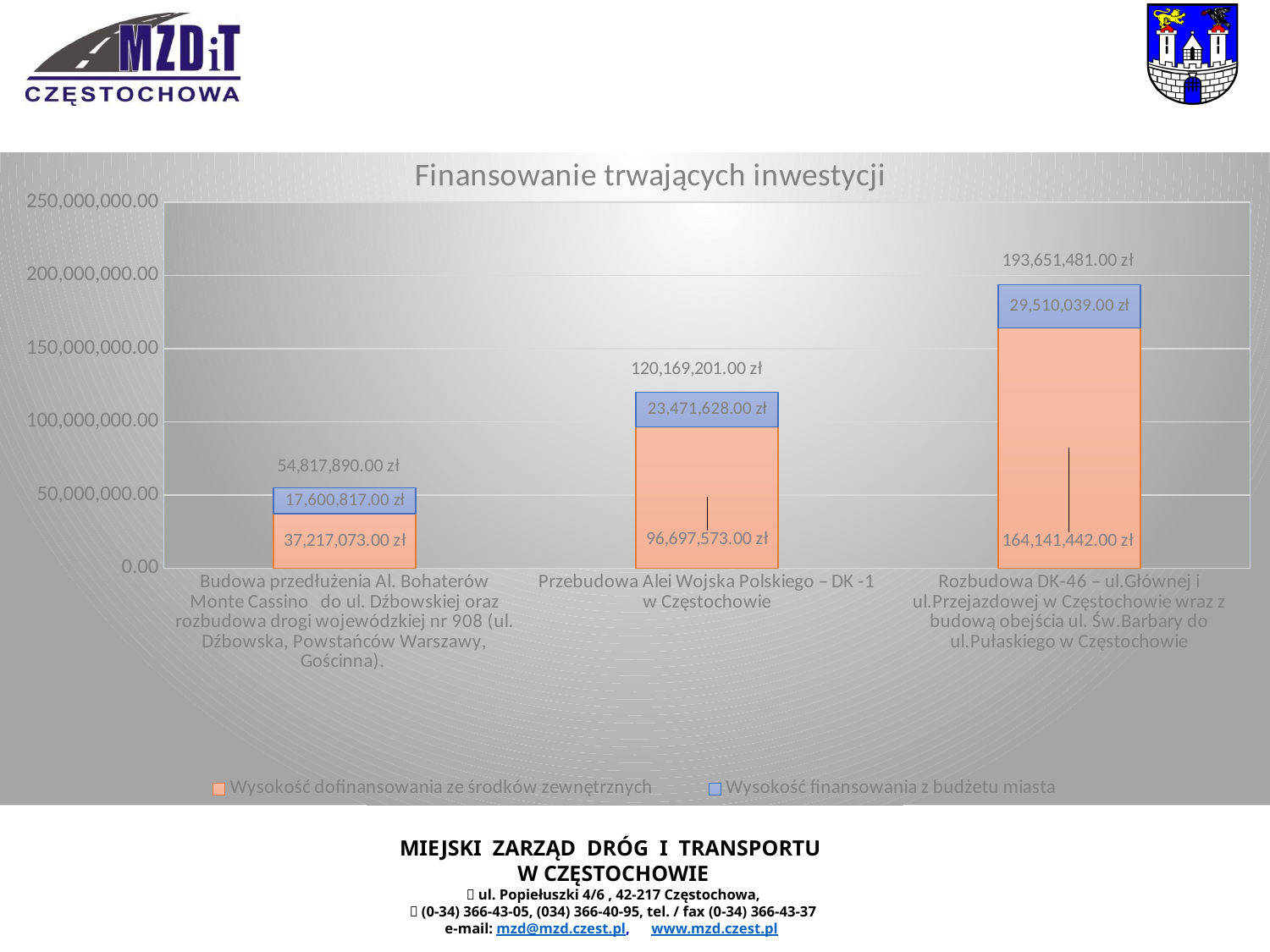
How many categories (investments) are shown on the x axis? 3 What is the value of 'Wysokość finansowania z budżetu miasta' for 'Rozbudowa DK-46 – ul.Głównej i ul.Przejazdowej w Częstochowie wraz z budową obejścia ul. Św.Barbary do ul.Pułaskiego w Częstochowie'? 29,510,039.00 zł How many series does the legend list? 2 What is the difference between the total financing of 'Rozbudowa DK-46' and 'Przebudowa Alei Wojska Polskiego – DK -1 w Częstochowie'? 73,482,280.00 zł What is the total of the stacked bar for 'Budowa przedłużenia Al. Bohaterów Monte Cassino do ul. Dźbowskiej oraz rozbudowa drogi wojewódzkiej nr 908'? 54,817,890.00 zł What is the value of 'Wysokość dofinansowania ze środków zewnętrznych' for 'Przebudowa Alei Wojska Polskiego – DK -1 w Częstochowie'? 96,697,573.00 zł Which is larger: 'Wysokość finansowania z budżetu miasta' for 'Przebudowa Alei Wojska Polskiego – DK -1' or for 'Budowa przedłużenia Al. Bohaterów Monte Cassino'? Przebudowa Alei Wojska Polskiego – DK -1 w Częstochowie What kind of chart is shown on the slide? Stacked bar chart Which investment has the highest total financing? Rozbudowa DK-46 – ul.Głównej i ul.Przejazdowej w Częstochowie wraz z budową obejścia ul. Św.Barbary do ul.Pułaskiego w Częstochowie What is the title of the chart? Finansowanie trwających inwestycji Do the total values of the stacked bars rise or fall from left to right along the x axis? Rise Which investment has the lowest value of 'Wysokość finansowania z budżetu miasta'? Budowa przedłużenia Al. Bohaterów Monte Cassino do ul. Dźbowskiej oraz rozbudowa drogi wojewódzkiej nr 908